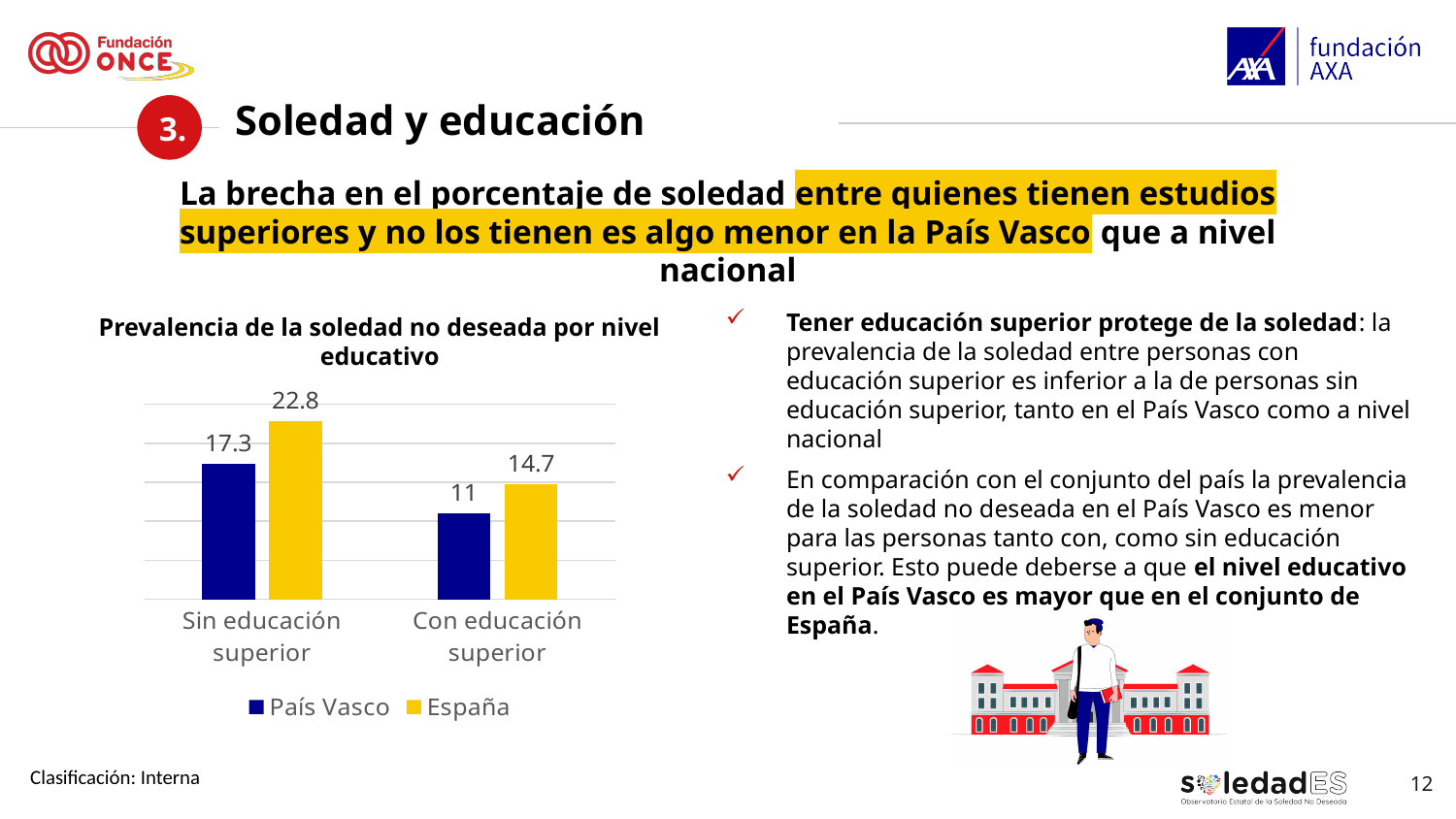
Which is larger for 'Con educación superior': the País Vasco value or the España value? España What is the value for España in the 'Sin educación superior' category? 22.8 What is the difference between the España and País Vasco values for 'Con educación superior'? 3.7 What is the value for País Vasco in the 'Con educación superior' category? 11 How many series does the chart's legend list? 2 Which bar in the chart has the lowest value? País Vasco, Con educación superior What type of chart is shown on the slide? Bar chart What is the value for España in the 'Con educación superior' category? 14.7 Which bar in the chart has the highest value? España, Sin educación superior How many categories are shown on the x axis of the chart? 2 What is the value for País Vasco in the 'Sin educación superior' category? 17.3 What is the difference between the España and País Vasco values for 'Sin educación superior'? 5.5